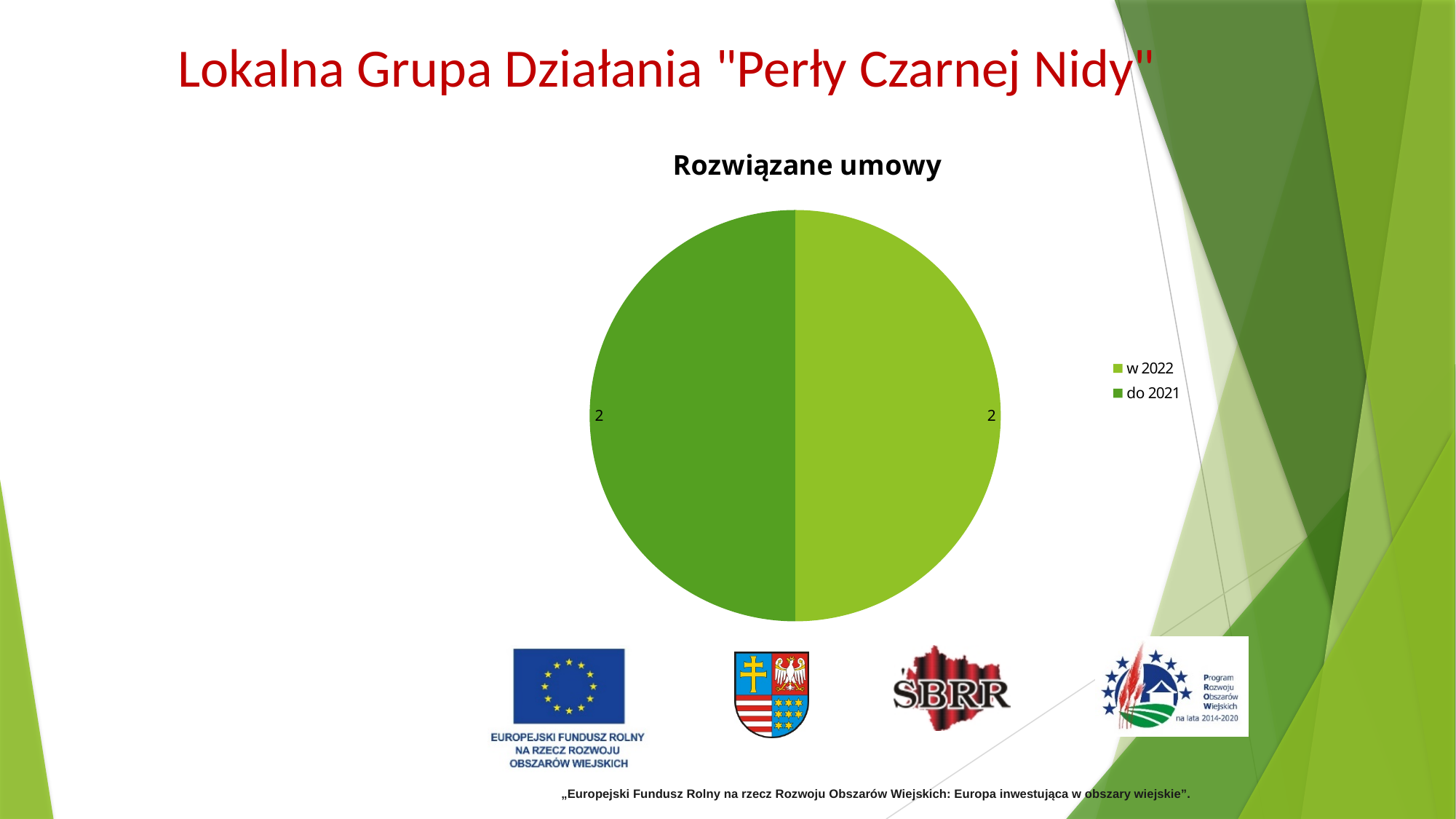
What share of the pie does the "do 2021" slice represent? 50% How many slices does the pie chart have? 2 What share of the pie does the "w 2022" slice represent? 50% Which legend entry is listed first in the chart legend? w 2022 What is the difference between the values for "w 2022" and "do 2021"? 0 What type of chart is shown on the slide? pie chart What is the title of the chart? Rozwiązane umowy What is the value for "do 2021"? 2 What is the total of all slices in the pie chart? 4 How many entries does the legend list? 2 What is the value for "w 2022"? 2